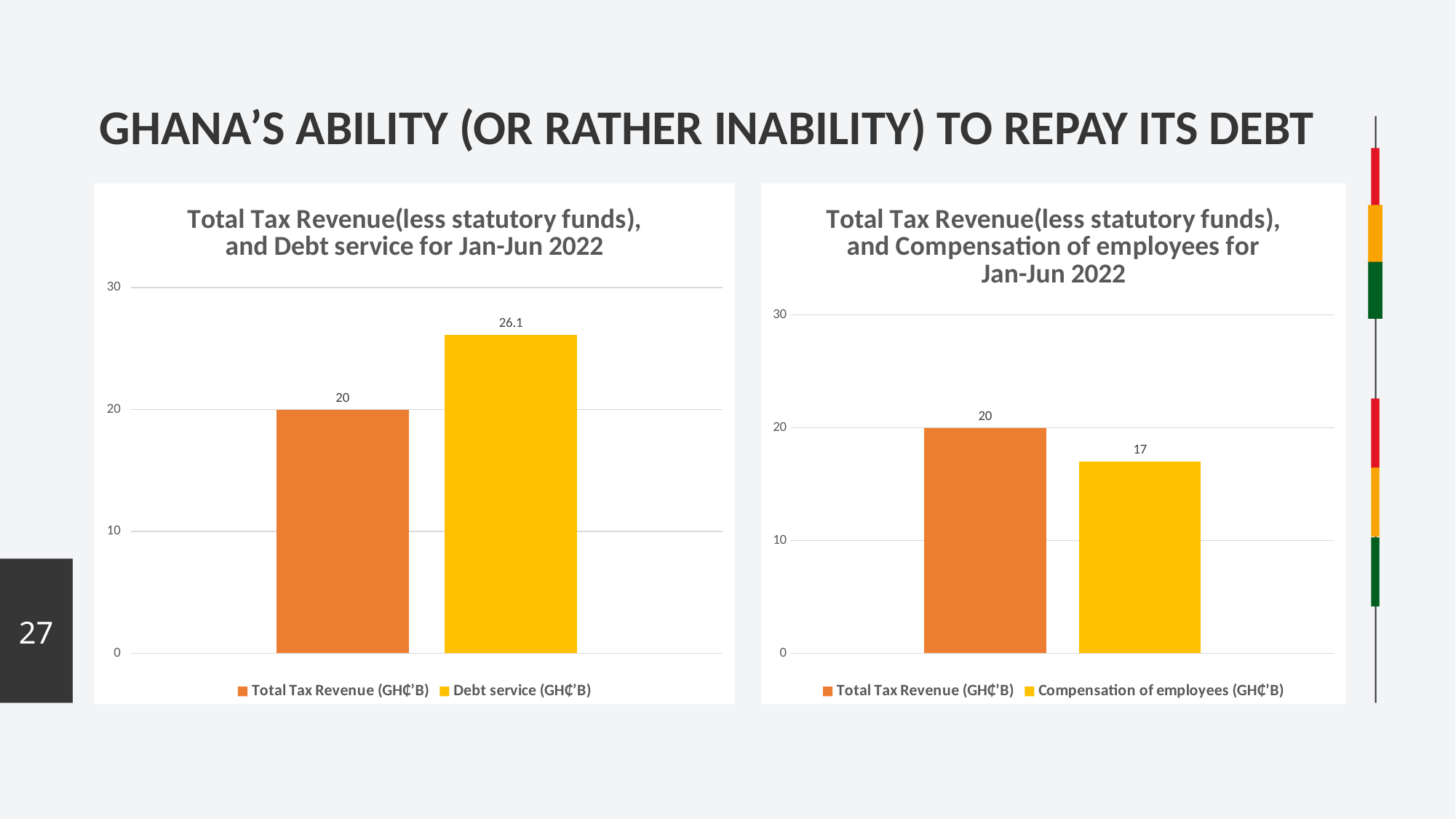
In the left chart (Debt service), what is the value for Debt service (GH₵'B)? 26.1 What colour is the Total Tax Revenue bar in the left chart (Debt service)? orange What kind of chart is the right chart (Compensation of employees)? bar chart In the right chart (Compensation of employees), what is the difference between Total Tax Revenue and Compensation of employees? 3 In the left chart (Debt service), what is the value for Total Tax Revenue (GH₵'B)? 20 In the left chart (Debt service), is the value for Debt service greater or less than 20? greater In the right chart (Compensation of employees), what is the value for Compensation of employees (GH₵'B)? 17 How many series does the legend of the left chart (Debt service) list? 2 In the left chart (Debt service), what is the difference between Debt service and Total Tax Revenue? 6.1 In the right chart (Compensation of employees), is Total Tax Revenue larger or smaller than Compensation of employees? larger In the left chart (Debt service), which series has the higher value? Debt service (GH₵'B) In the right chart (Compensation of employees), which series has the lower value? Compensation of employees (GH₵'B)